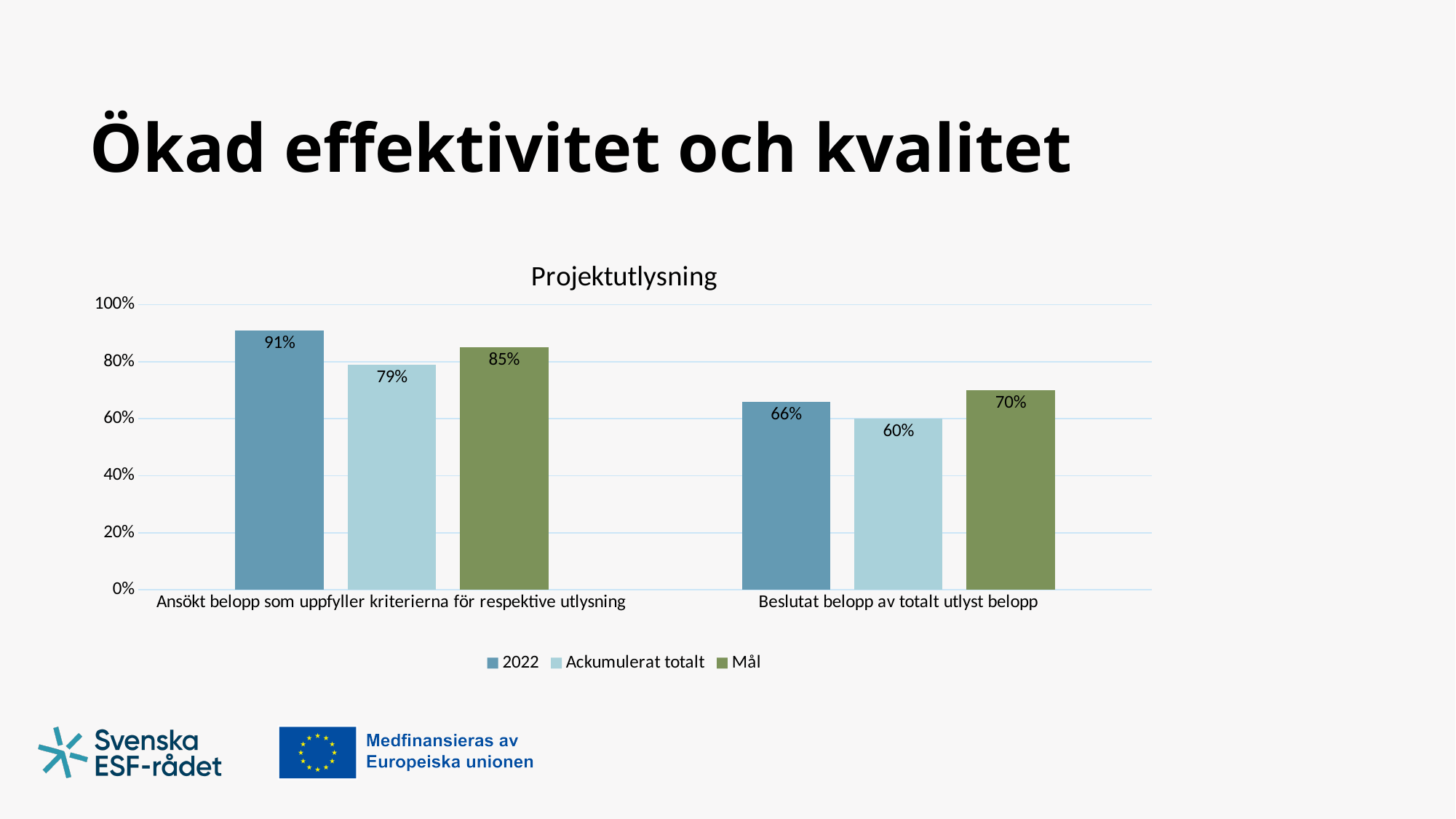
What is the 2022 value for "Ansökt belopp som uppfyller kriterierna för respektive utlysning"? 91% How many series does the legend list? 3 Which series has the highest value for "Ansökt belopp som uppfyller kriterierna för respektive utlysning"? 2022 What is the Ackumulerat totalt value for "Beslutat belopp av totalt utlyst belopp"? 60% How many categories are shown on the x axis? 2 What is the title of the chart? Projektutlysning What is the difference between the Mål value and the 2022 value for "Beslutat belopp av totalt utlyst belopp"? 4% Which is larger: the Ackumulerat totalt value for "Ansökt belopp som uppfyller kriterierna för respektive utlysning" or the Mål value for "Beslutat belopp av totalt utlyst belopp"? Ackumulerat totalt for Ansökt belopp som uppfyller kriterierna för respektive utlysning What is the Mål value for "Beslutat belopp av totalt utlyst belopp"? 70% Which series has the lowest value for "Beslutat belopp av totalt utlyst belopp"? Ackumulerat totalt What is the difference between the 2022 value and the Mål value for "Ansökt belopp som uppfyller kriterierna för respektive utlysning"? 6% What kind of chart is shown on the slide? Bar chart